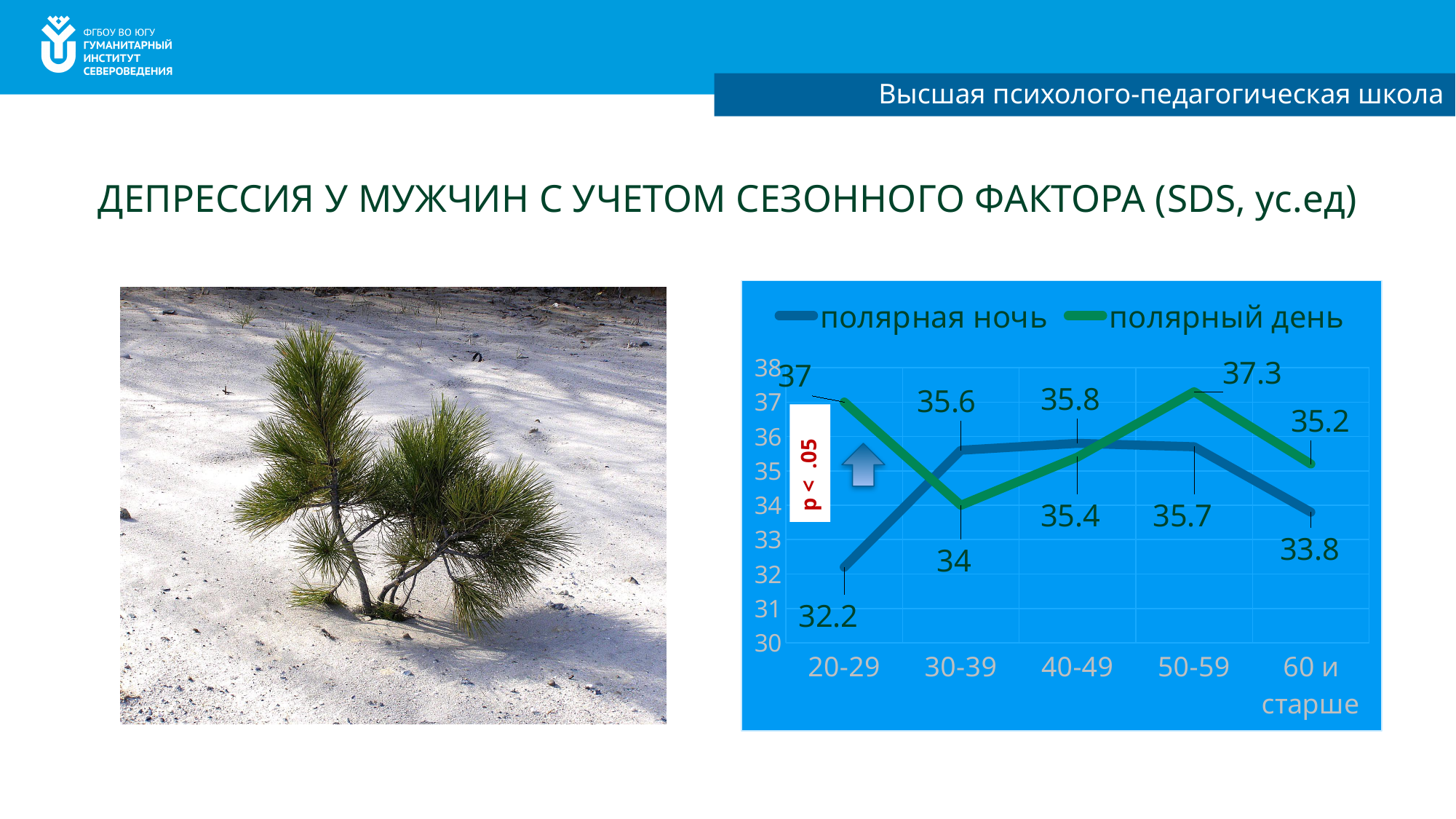
In which age group is the полярная ночь value highest? 40-49 What is the value for полярный день in the 20-29 age group? 37 What is the value for полярный день in the 50-59 age group? 37.3 What kind of chart is shown on the slide? line chart What is the difference between полярный день and полярная ночь in the 20-29 age group? 4.8 What is the value for полярная ночь in the 60 и старше age group? 33.8 How many series does the chart legend list? 2 What is the value for полярная ночь in the 20-29 age group? 32.2 In which age group is the полярный день value lowest? 30-39 Which series is drawn in green in the chart? полярный день Which series has the larger value in the 30-39 age group, полярная ночь or полярный день? полярная ночь How many age categories are shown on the x axis of the chart? 5